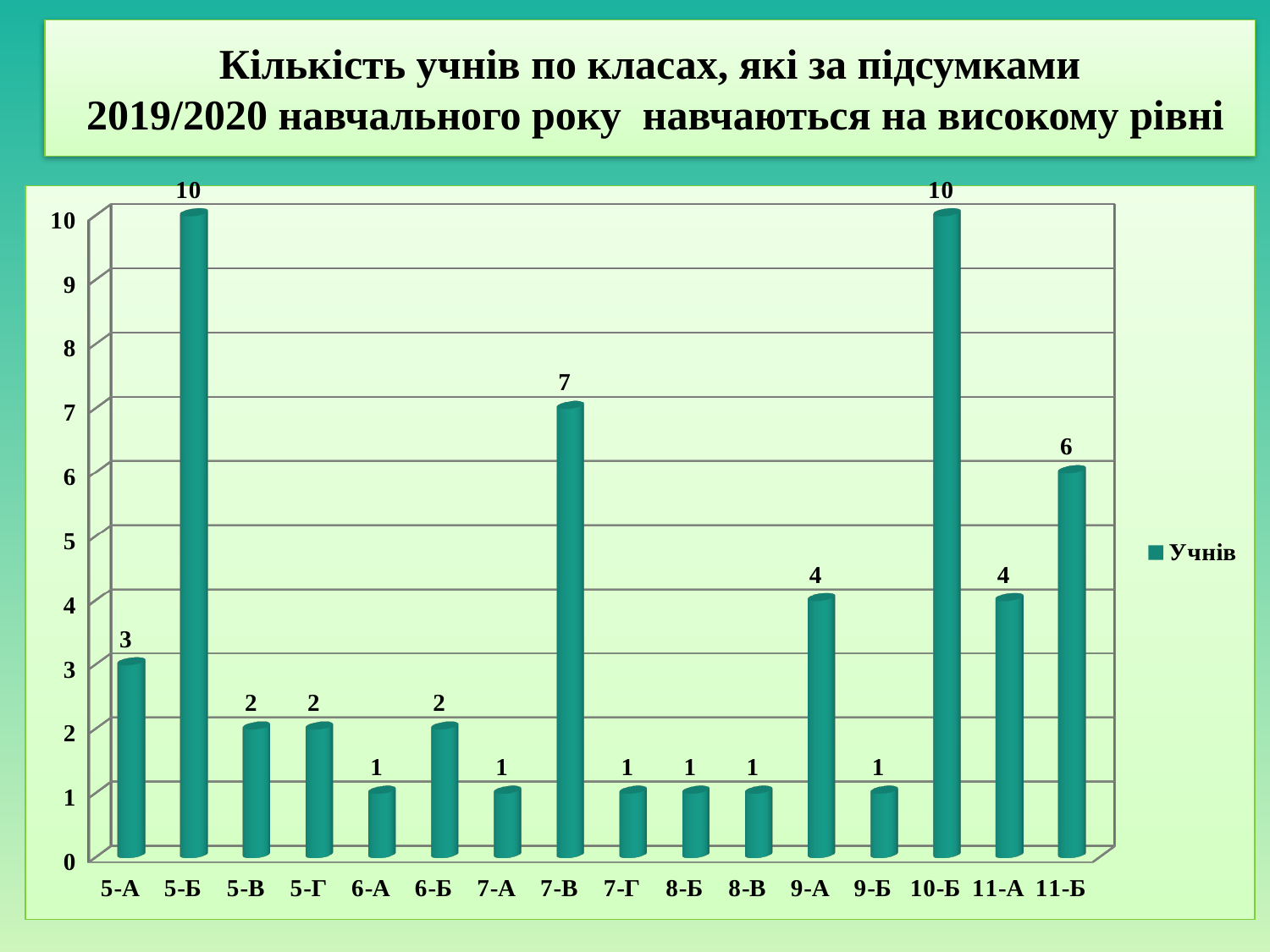
What is the value for 11-Б? 6 What is the value for 7-В? 7 What is the value for 9-А? 4 Which two classes share the highest value on the chart? 5-Б and 10-Б How many classes are shown on the x axis? 16 What is the value for 5-А? 3 Which is larger, the value for 5-А or the value for 5-В? 5-А Which is larger, the value for 9-А or the value for 11-Б? 11-Б What is the difference between the values for 5-Б and 7-В? 3 What kind of chart is shown on the slide? Bar chart How many series does the legend list? 1 What is the difference between the values for 11-Б and 11-А? 2